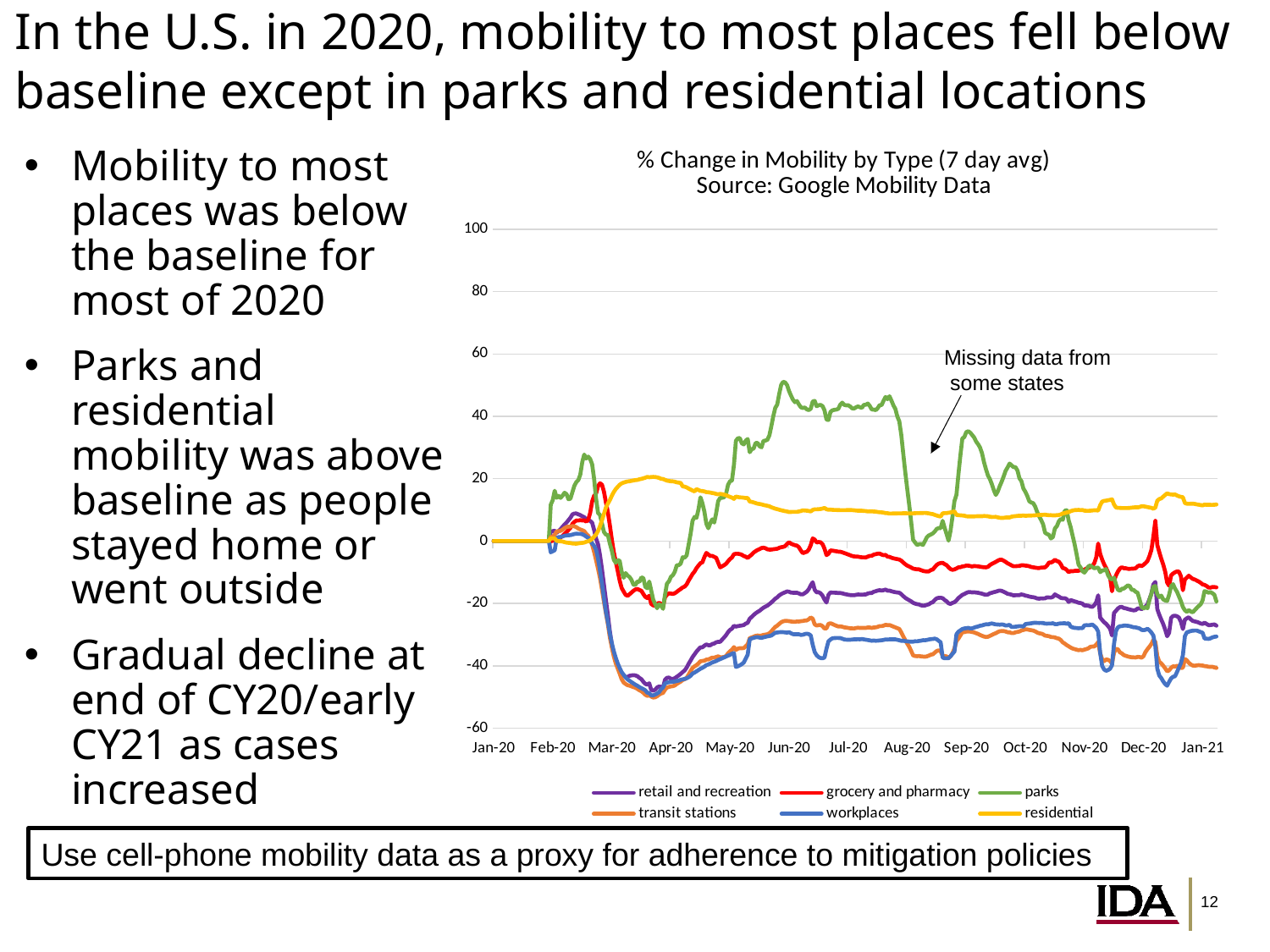
How many series does the chart's legend list? 6 Is the value for parks around Jun-20 greater or less than 40? greater What kind of chart is shown on the slide? line chart Is the value for residential around Apr-20 greater or less than 0? greater Which series has the highest value around Jun-20? parks Is the value for workplaces around Apr-20 greater or less than -40? less Does the residential series rise or fall between Apr-20 and Sep-20? fall According to the chart subtitle, what is the source of the data? Google Mobility Data What is the title of the chart? % Change in Mobility by Type (7 day avg) Around Apr-20, which is larger: the value for residential or the value for retail and recreation? residential How many month labels are shown on the x axis? 13